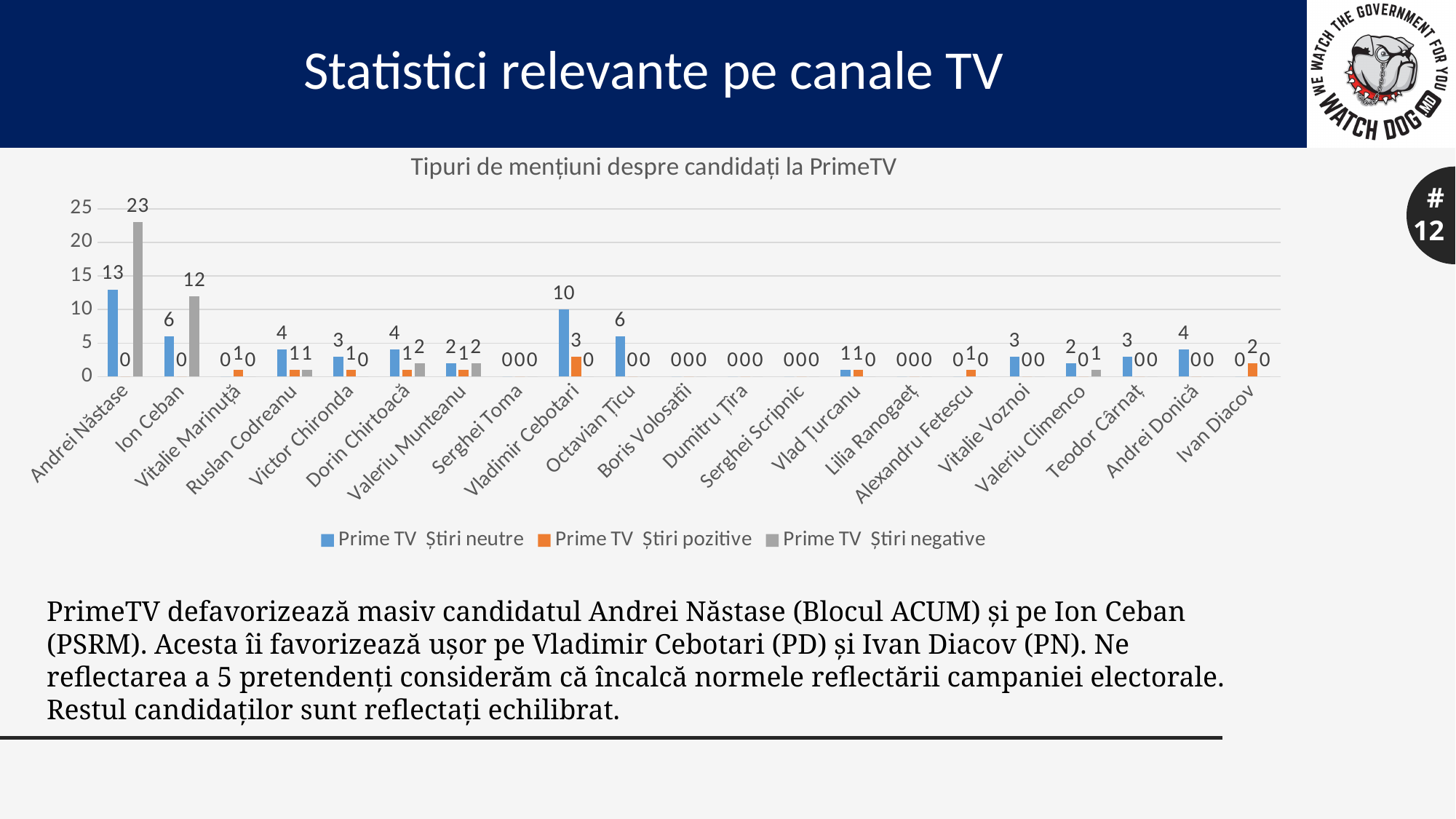
What is the difference between the Prime TV Știri negative values for Andrei Năstase and Ion Ceban? 11 How many series does the legend list? 3 Which candidate has the highest value for Prime TV Știri negative? Andrei Năstase What type of chart is shown on the slide? Bar chart What is the value of Prime TV Știri pozitive for Ivan Diacov? 2 What is the title of the chart? Tipuri de mențiuni despre candidați la PrimeTV What is the value of Prime TV Știri neutre for Vladimir Cebotari? 10 Which is larger: Prime TV Știri neutre for Ion Ceban or for Vladimir Cebotari? Vladimir Cebotari Which candidate has the highest value for Prime TV Știri pozitive? Vladimir Cebotari How many candidates are shown on the x axis of the chart? 21 Is the value of Prime TV Știri negative for Andrei Năstase greater or less than 20? greater What is the value of Prime TV Știri negative for Andrei Năstase? 23